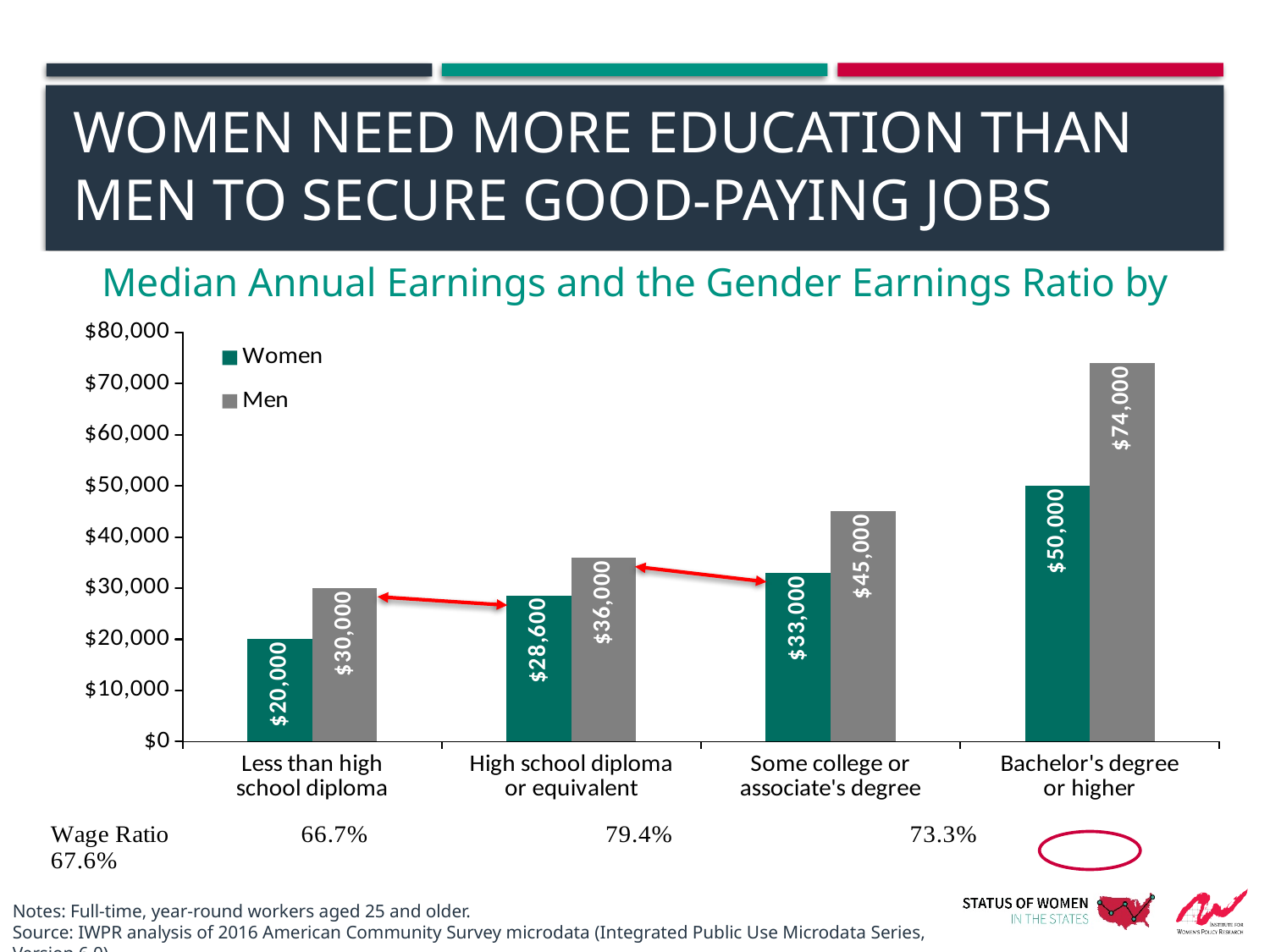
What kind of chart is shown on the slide? Bar chart What is the difference between men's and women's median annual earnings for those with a bachelor's degree or higher? $24,000 What are the median annual earnings for men with some college or an associate's degree? $45,000 What are the median annual earnings for women with less than a high school diploma? $20,000 Which education category has the highest median annual earnings for men? Bachelor's degree or higher How many series does the legend list? 2 Do women's median annual earnings rise or fall as education level increases along the x axis? Rise How many education categories are shown on the x axis? 4 What are the median annual earnings for men with a bachelor's degree or higher? $74,000 What are the median annual earnings for women with a high school diploma or equivalent? $28,600 Which education category has the lowest median annual earnings for women? Less than high school diploma Which is larger: women's earnings with some college or associate's degree, or men's earnings with a high school diploma or equivalent? Men's earnings with a high school diploma or equivalent